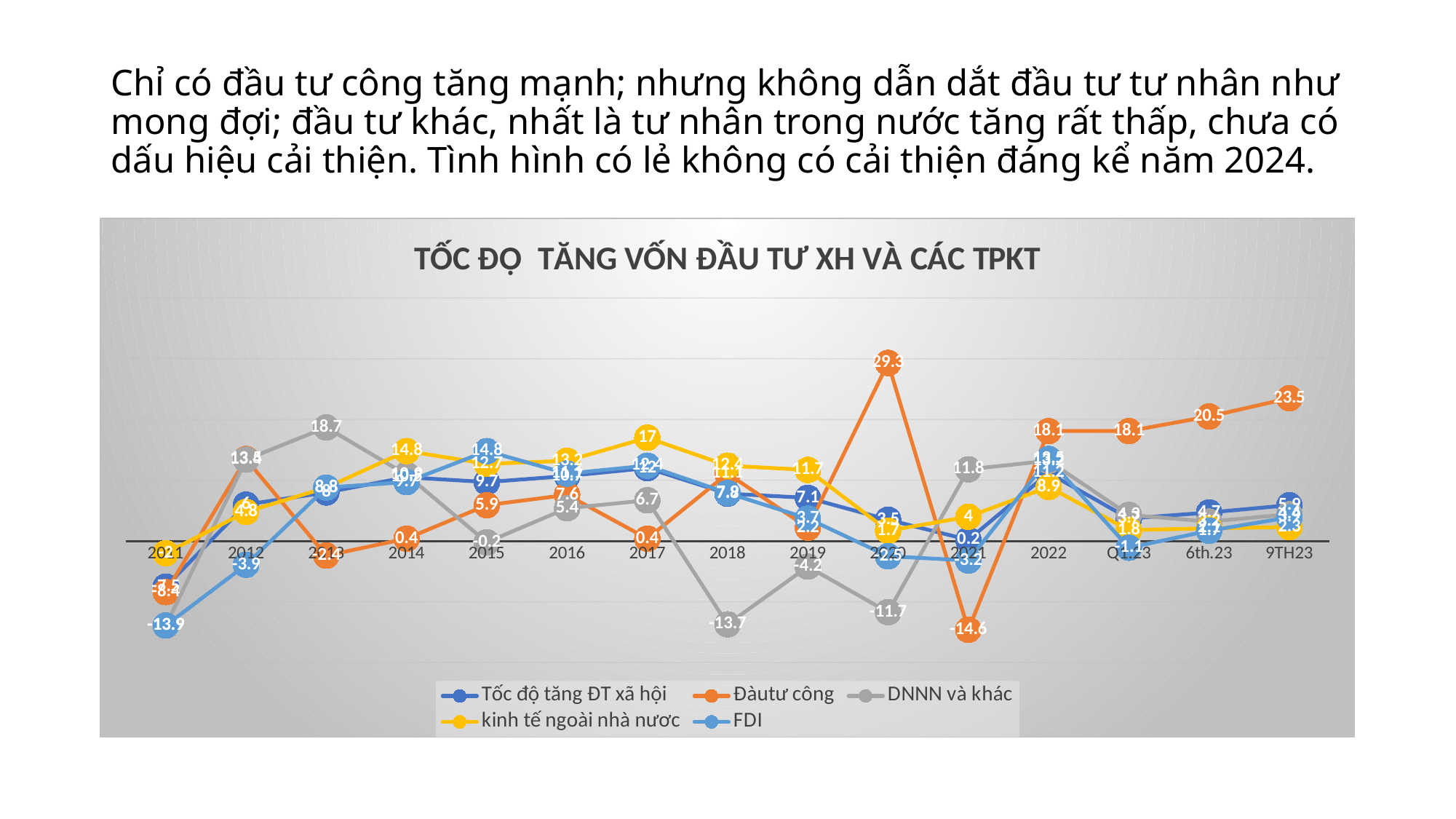
What is the value for DNNN và khác in 2013? 18.7 What is the value for Đầutư công at 9TH23? 23.5 What is the value for Đầutư công in 2020? 29.3 In which period does Đầutư công reach its highest value? 2020 What kind of chart is shown on the slide? Line chart How many series does the legend list? 5 Does the Đầutư công line rise or fall from Q1.23 to 9TH23? Rise What is the difference between the Đầutư công values at 9TH23 and 6th.23? 3 How many time periods are shown along the x axis? 15 In 2021, which is larger: Đầutư công or DNNN và khác? DNNN và khác What is the value for DNNN và khác in 2018? -13.7 In which period does Đầutư công reach its lowest value? 2021